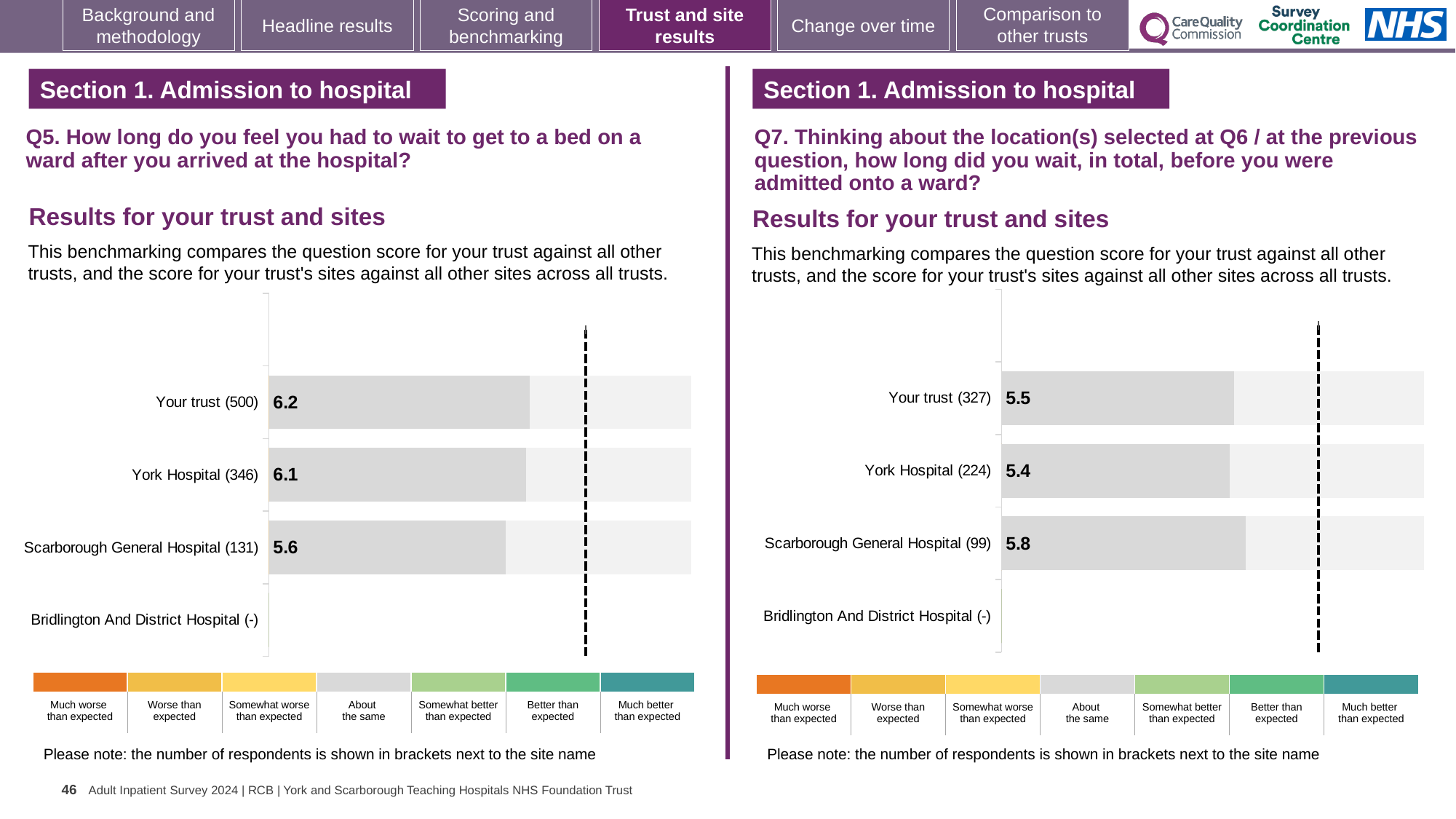
On the Q5 chart (left), which has the higher score: York Hospital or Scarborough General Hospital? York Hospital On the Q5 chart (left), what is the difference between the scores for Your trust and Scarborough General Hospital? 0.6 On the Q5 chart (left), how many respondents are shown in brackets for York Hospital? 346 On the Q7 chart (right), what is the score for Scarborough General Hospital? 5.8 On the Q7 chart (right), what is the difference between the scores for Scarborough General Hospital and York Hospital? 0.4 On the Q7 chart (right), what is the score for York Hospital? 5.4 What kind of chart is used on the Q5 chart (left)? Bar chart On the Q5 chart (left), which site or trust row has the lowest score shown? Scarborough General Hospital On the Q5 chart (left), what is the score for Your trust? 6.2 How many rows (trust and sites) are listed on the Q7 chart (right)? 4 On the Q7 chart (right), which site or trust row has the highest score shown? Scarborough General Hospital On the Q5 chart (left), what is the score for Scarborough General Hospital? 5.6